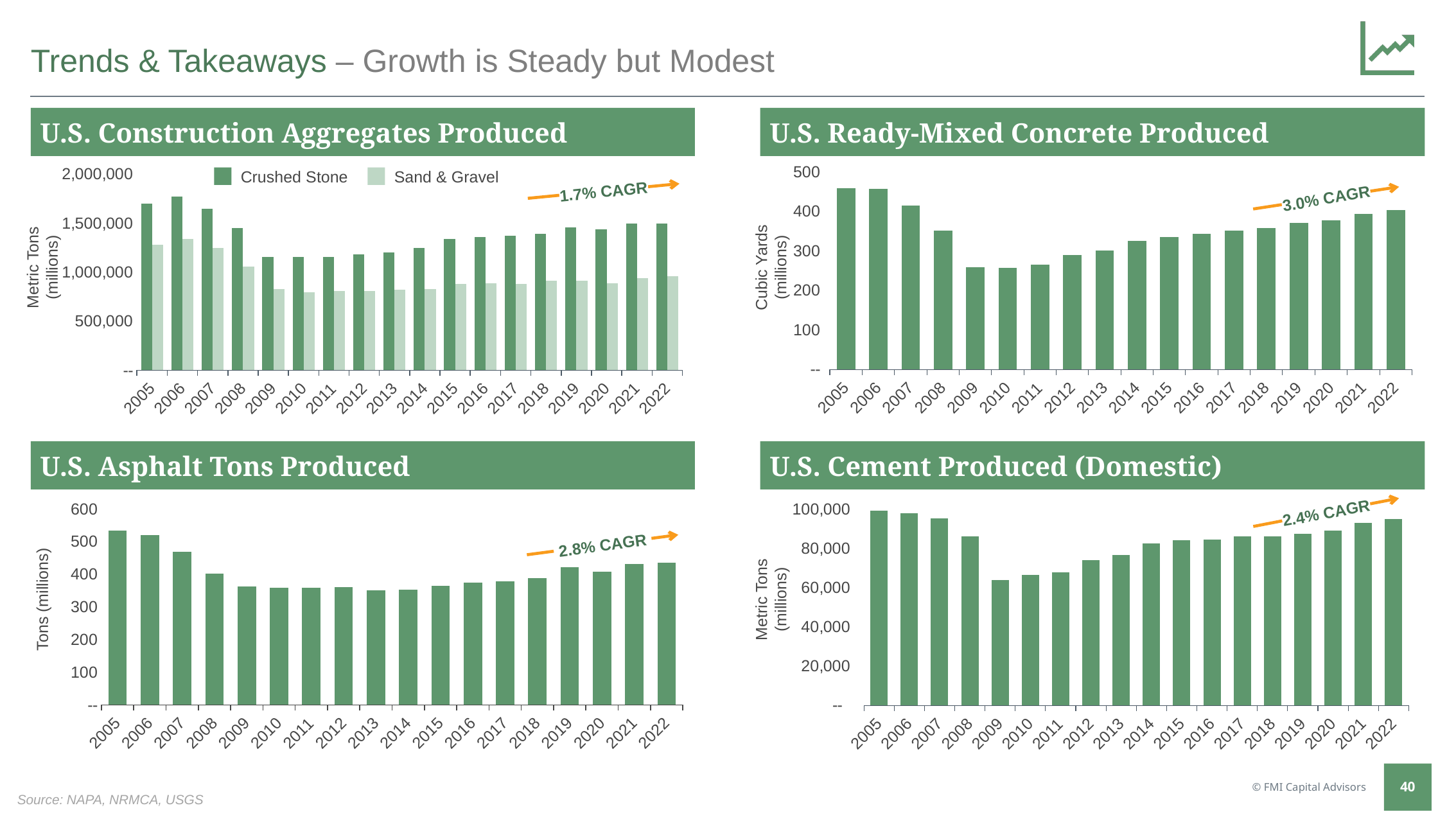
In the U.S. Construction Aggregates Produced chart, is the Crushed Stone value for 2006 greater or less than 1,500,000? greater In the U.S. Construction Aggregates Produced chart, is the Sand & Gravel value for 2010 greater or less than 1,000,000? less In the U.S. Ready-Mixed Concrete Produced chart, how many years are shown on the x axis? 18 What CAGR is annotated on the U.S. Cement Produced (Domestic) chart? 2.4% CAGR In the U.S. Cement Produced (Domestic) chart, which year has the lowest value? 2009 In the U.S. Ready-Mixed Concrete Produced chart, is the value for 2010 greater or less than 300? less In the U.S. Construction Aggregates Produced chart, which year has the highest Crushed Stone value? 2006 What type of chart is the U.S. Asphalt Tons Produced chart? Bar chart In the U.S. Asphalt Tons Produced chart, which year has the highest value? 2005 In the U.S. Ready-Mixed Concrete Produced chart, which is larger, the value for 2005 or the value for 2022? 2005 In the U.S. Construction Aggregates Produced chart, how many series does the legend list? 2